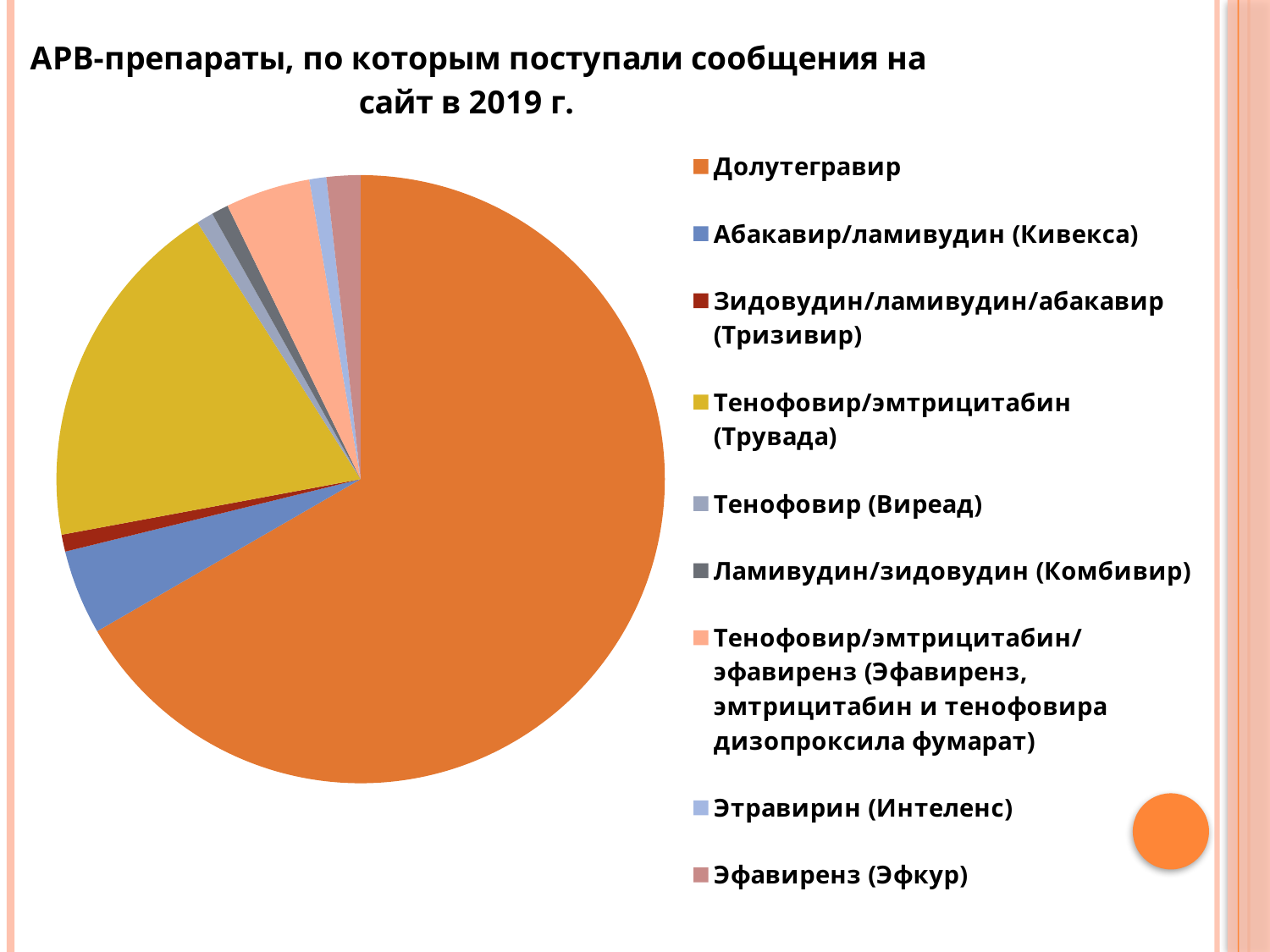
Which category has the second-largest slice of the pie chart? Тенофовир/эмтрицитабин (Трувада) Is the share of the pie for Долутегравир greater or less than 50%? greater What colour is the slice for Долутегравир? Orange Which is larger: the slice for Тенофовир/эмтрицитабин/эфавиренз or the slice for Эфавиренз (Эфкур)? Тенофовир/эмтрицитабин/эфавиренз Which is larger: the slice for Долутегравир or the slice for Тенофовир/эмтрицитабин (Трувада)? Долутегравир What is the title of the chart? АРВ-препараты, по которым поступали сообщения на сайт в 2019 г. Which category has the largest slice of the pie chart? Долутегравир How many categories (slices) does the pie chart have? 9 Which is larger: the slice for Тенофовир/эмтрицитабин (Трувада) or the slice for Абакавир/ламивудин (Кивекса)? Тенофовир/эмтрицитабин (Трувада) What kind of chart is shown on the slide? Pie chart